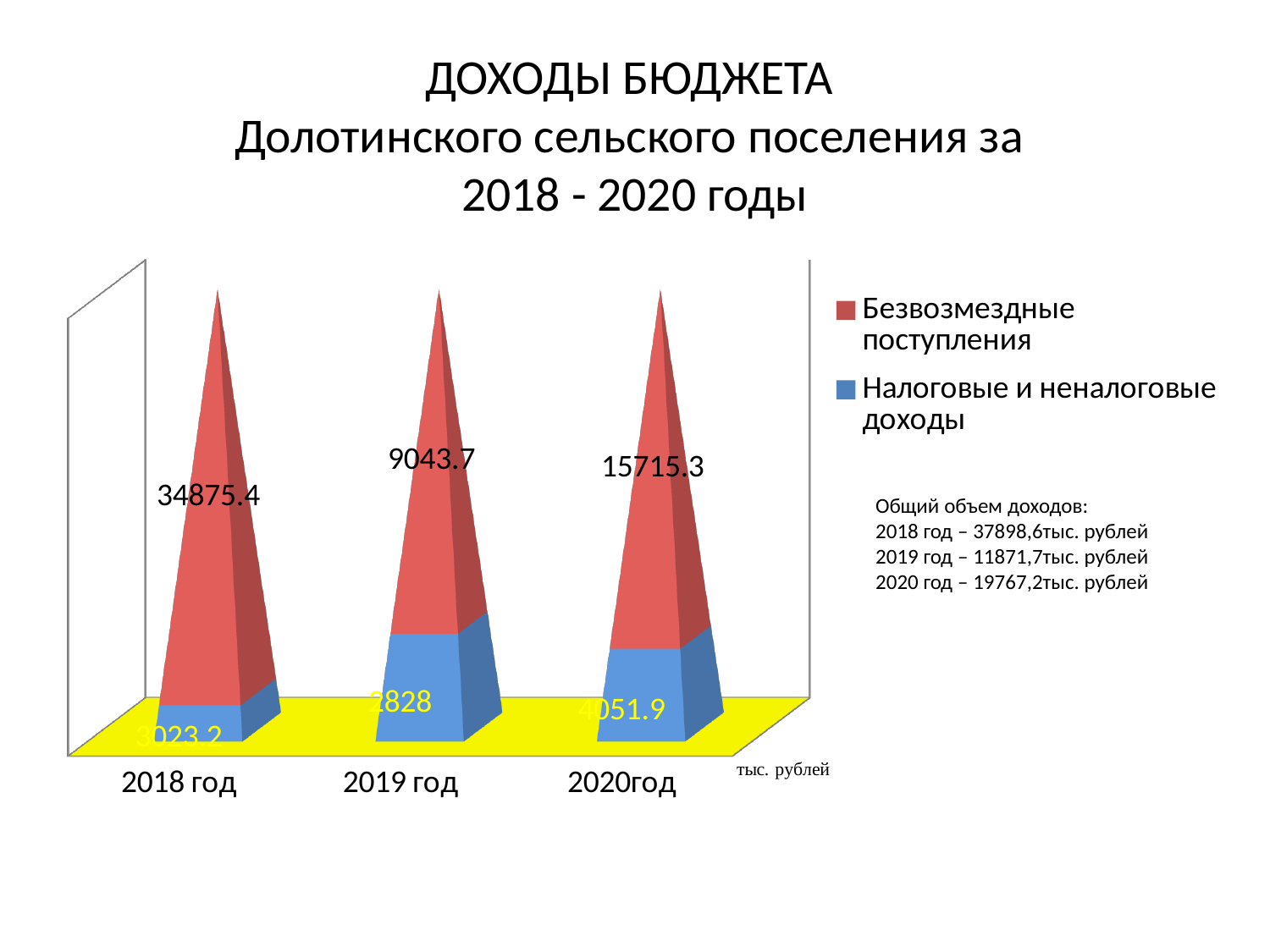
What is the value of Налоговые и неналоговые доходы for 2019 год? 2828 How many series does the legend list? 2 What is the value of Безвозмездные поступления for 2020год? 15715.3 Which series is shown in red? Безвозмездные поступления How many years (categories) are shown on the x axis? 3 What is the difference between Безвозмездные поступления in 2018 год and in 2019 год? 25831.7 What is the total of the stacked bar for 2019 год? 11871.7 In which year is the value of Налоговые и неналоговые доходы lowest? 2019 год What is the value of Налоговые и неналоговые доходы for 2020год? 4051.9 What is the value of Безвозмездные поступления for 2018 год? 34875.4 In which year is the value of Безвозмездные поступления highest? 2018 год Which is larger: Налоговые и неналоговые доходы in 2020год or in 2019 год? 2020год